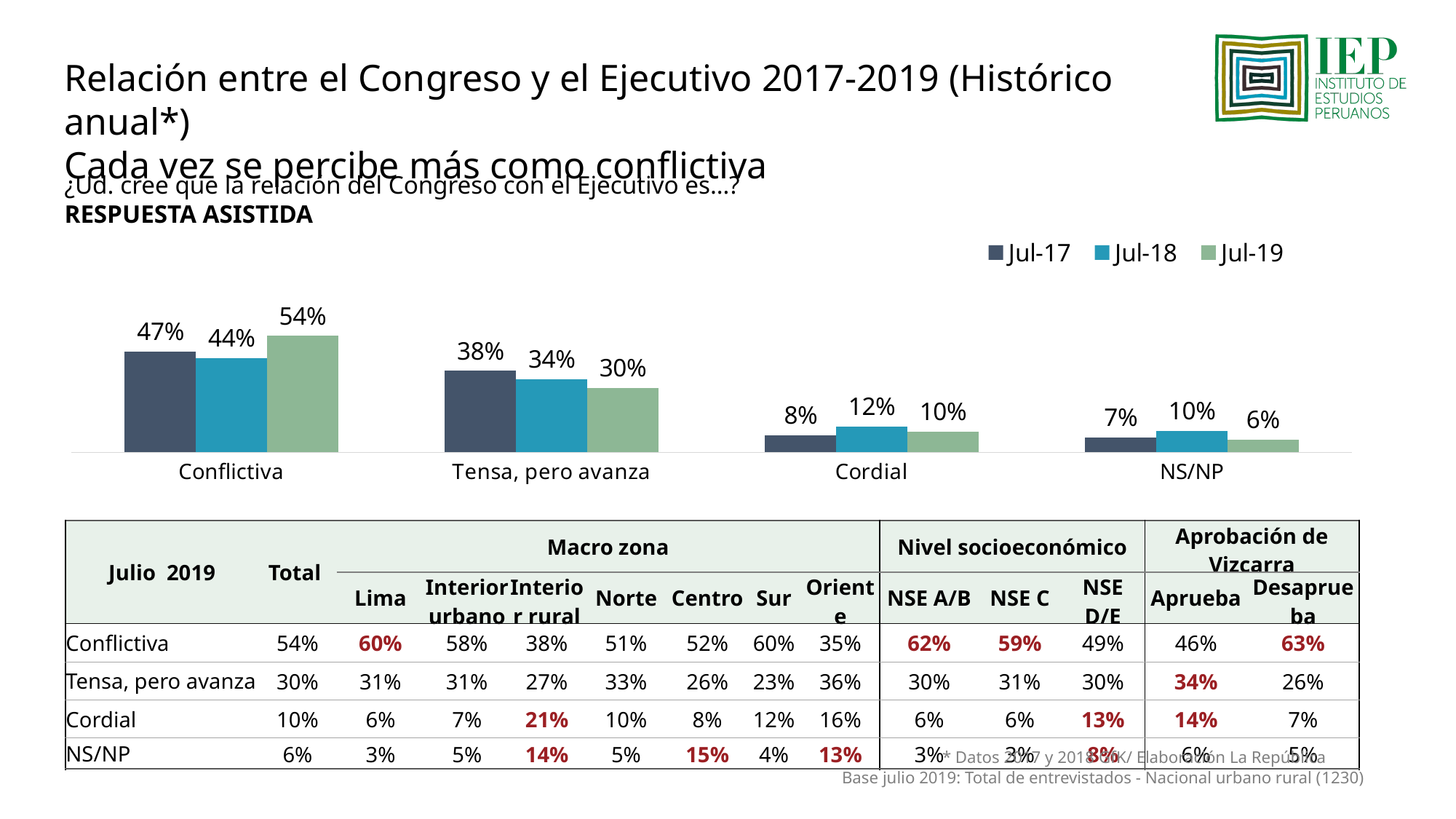
What is the difference between the Jul-19 and Jul-18 values for Conflictiva? 10% How many series does the legend list? 3 What is the Jul-17 value for Tensa, pero avanza? 38% Which category has the highest Jul-19 value? Conflictiva What is the difference between the Jul-17 and Jul-19 values for Tensa, pero avanza? 8% Which category has the lowest Jul-17 value? NS/NP What kind of chart is shown on the slide? Bar chart How many categories are shown on the x axis of the bar chart? 4 What is the Jul-18 value for Cordial? 12% What is the Jul-19 value for Conflictiva? 54% Do the values for Tensa, pero avanza rise or fall from Jul-17 to Jul-19? Fall Which is larger for Cordial: the Jul-18 value or the Jul-19 value? Jul-18